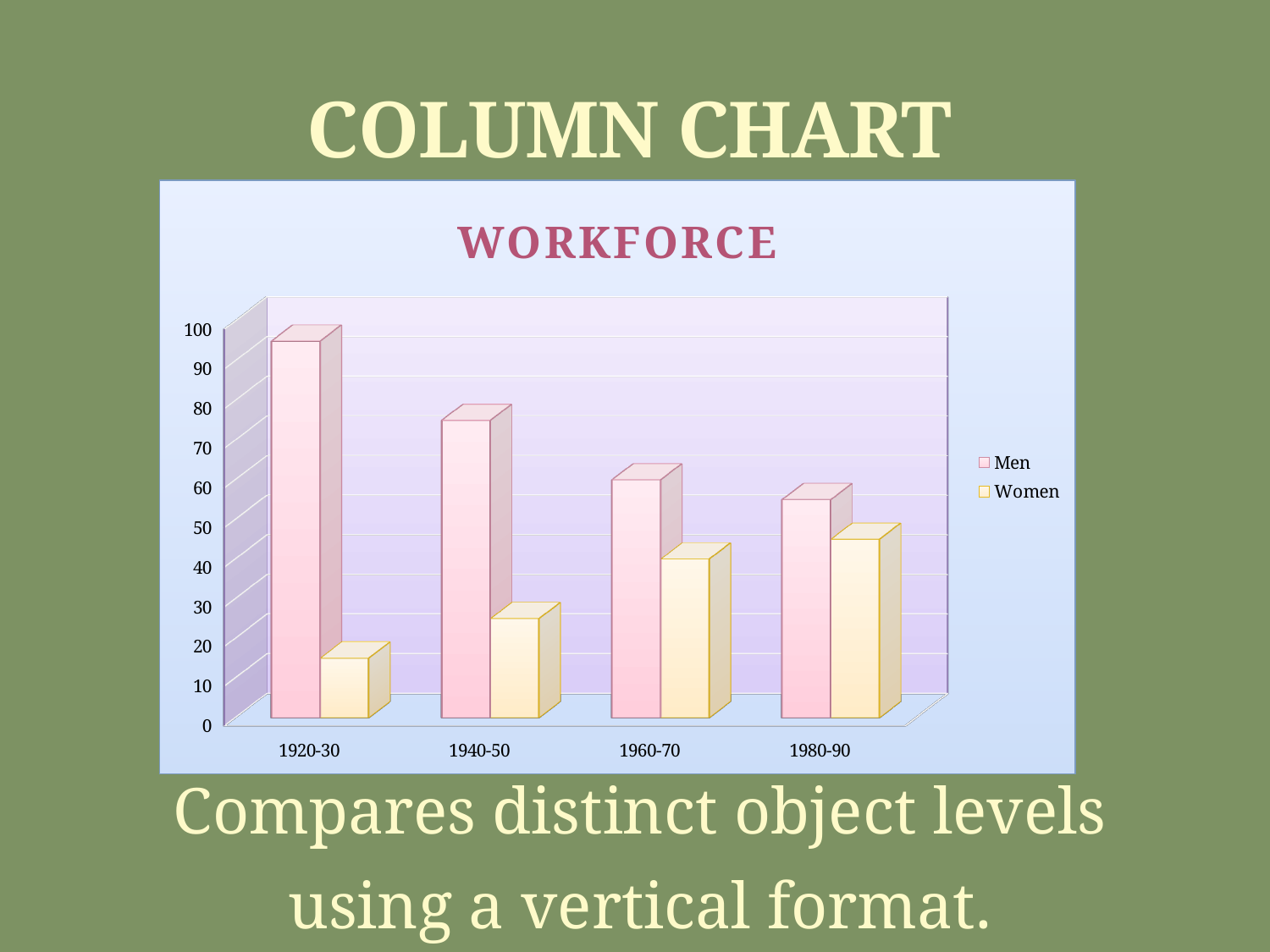
Which category has the highest value for Men? 1920-30 Which category has the lowest value for Women? 1920-30 What kind of chart is shown on the slide? bar chart Do the values for Men rise or fall from 1920-30 to 1980-90? fall Which category has the highest value for Women? 1980-90 Is the value for Men in 1920-30 greater or less than 80? greater Do the values for Women rise or fall from 1920-30 to 1980-90? rise What is the title of the chart? WORKFORCE Is the value for Women in 1920-30 greater or less than 20? less In 1960-70, which is larger, the value for Men or the value for Women? Men How many categories are shown on the x axis? 4 How many series does the legend list? 2